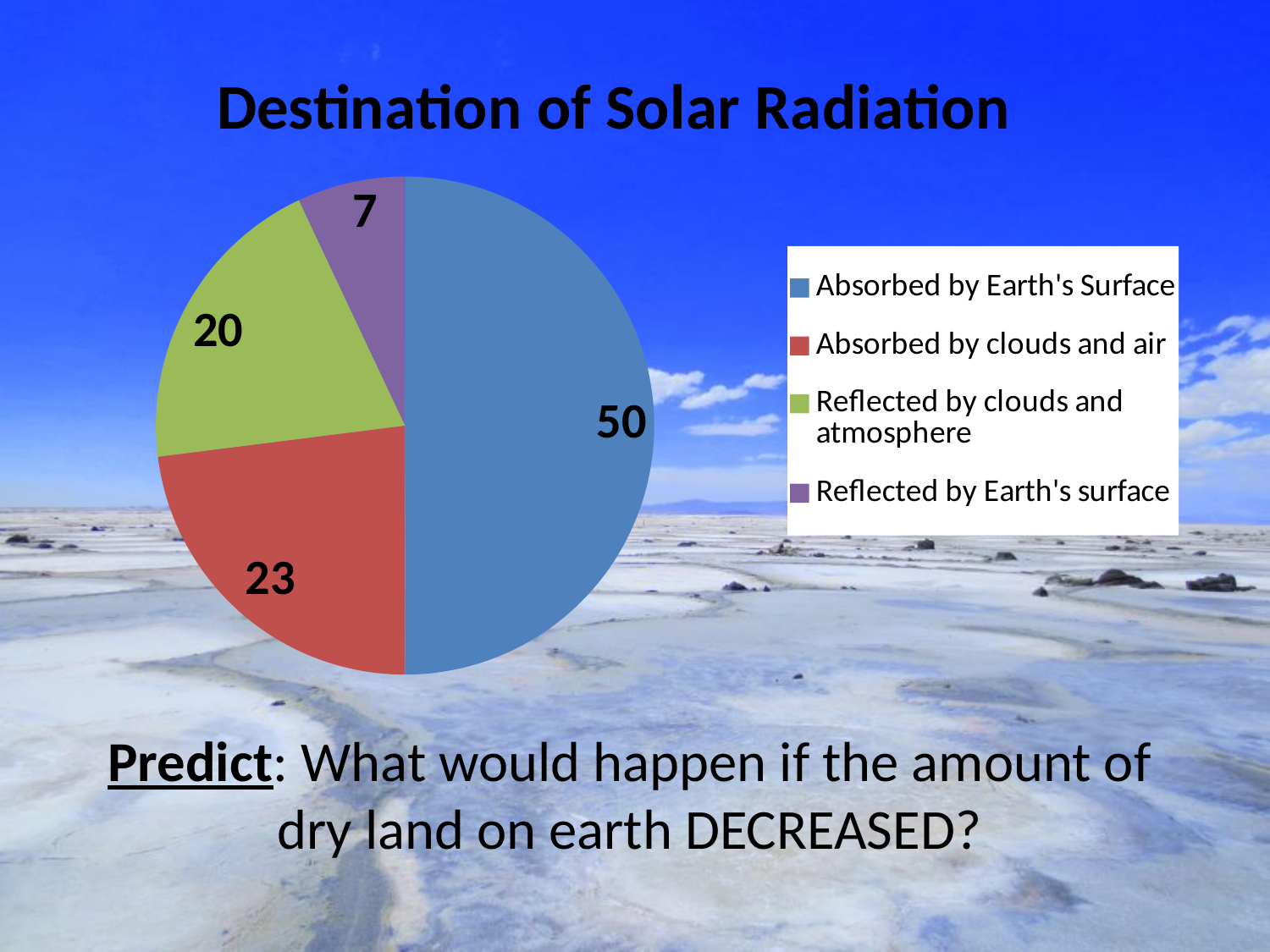
What value is shown for the 'Absorbed by Earth's Surface' slice? 50 What value is shown for the 'Reflected by clouds and atmosphere' slice? 20 Which category has the largest slice of the pie? Absorbed by Earth's Surface What share of the pie does the 'Absorbed by Earth's Surface' slice represent? 50% What is the difference between the 'Absorbed by Earth's Surface' value and the 'Absorbed by clouds and air' value? 27 What is the title of the chart? Destination of Solar Radiation Which is larger: 'Reflected by clouds and atmosphere' or 'Reflected by Earth's surface'? Reflected by clouds and atmosphere What kind of chart is shown on the slide? Pie chart What value is shown for the 'Absorbed by clouds and air' slice? 23 What value is shown for the 'Reflected by Earth's surface' slice? 7 How many slices does the pie chart have? 4 Which category has the smallest slice of the pie? Reflected by Earth's surface